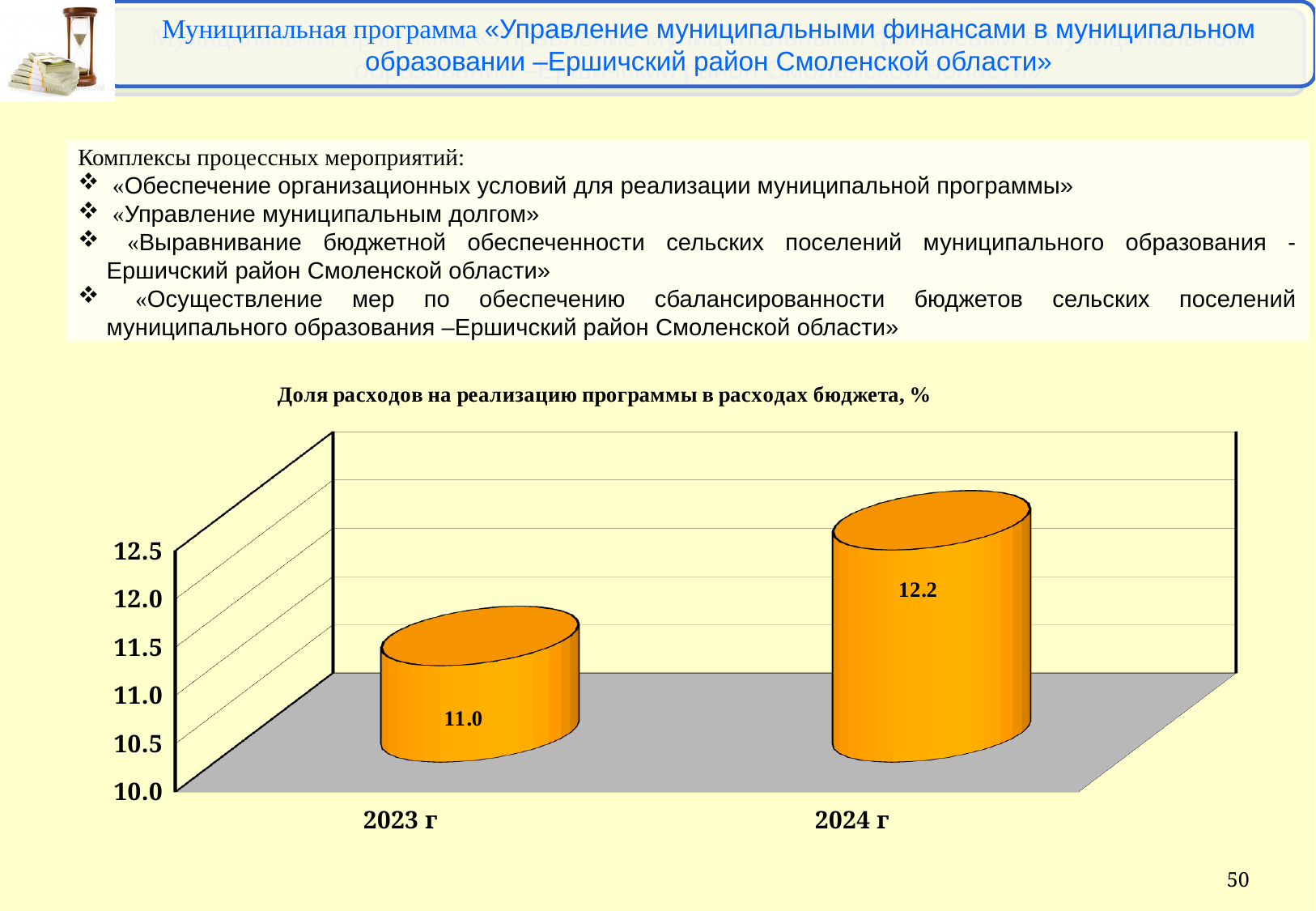
Which year has the lowest value in the chart? 2023 г What is the difference between the values for 2024 г and 2023 г? 1.2 What is the value for 2023 г in the chart? 11.0 What is the title of the chart? Доля расходов на реализацию программы в расходах бюджета, % What is the value for 2024 г in the chart? 12.2 Is the value for 2024 г greater or less than 12.0? greater What kind of chart is shown on the slide? bar chart Do the values rise or fall from 2023 г to 2024 г? rise Which is larger, the value for 2023 г or the value for 2024 г? 2024 г How many categories are shown on the x axis of the chart? 2 Is the value for 2023 г greater or less than 11.5? less Which year has the highest value in the chart? 2024 г